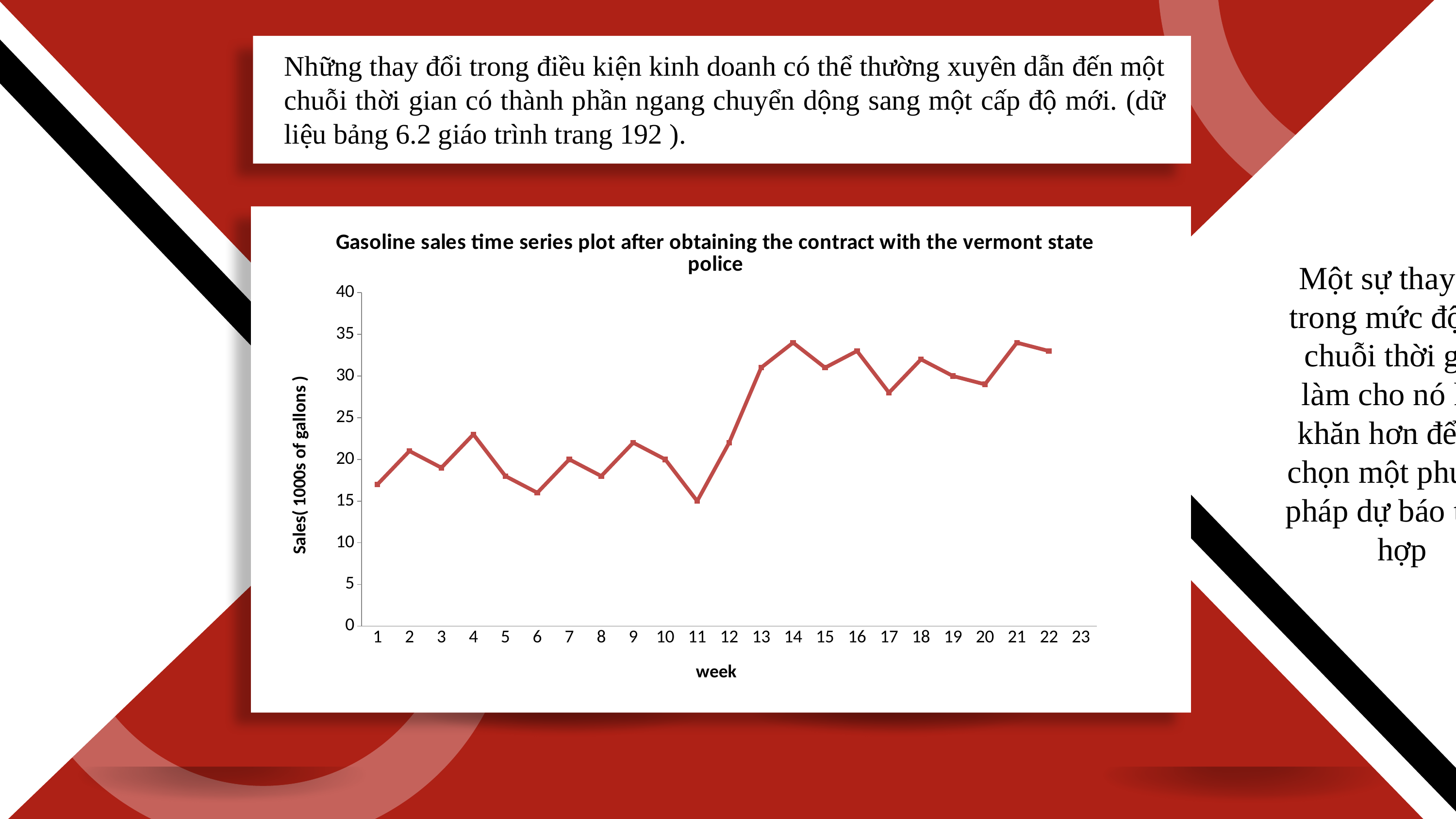
Is the sales value for week 4 greater or less than 20? greater Is the sales value for week 1 greater or less than 20? less Which week has the larger sales value, week 11 or week 12? week 12 Which week has the larger sales value, week 1 or week 14? week 14 What is the title of the chart? Gasoline sales time series plot after obtaining the contract with the vermont state police How many week labels are shown on the x axis? 23 Is the sales value for week 11 greater or less than 20? less Overall, do sales rise or fall from week 1 to week 22? rise What kind of chart is shown on the slide? line chart What is the label of the y axis? Sales( 1000s of gallons )